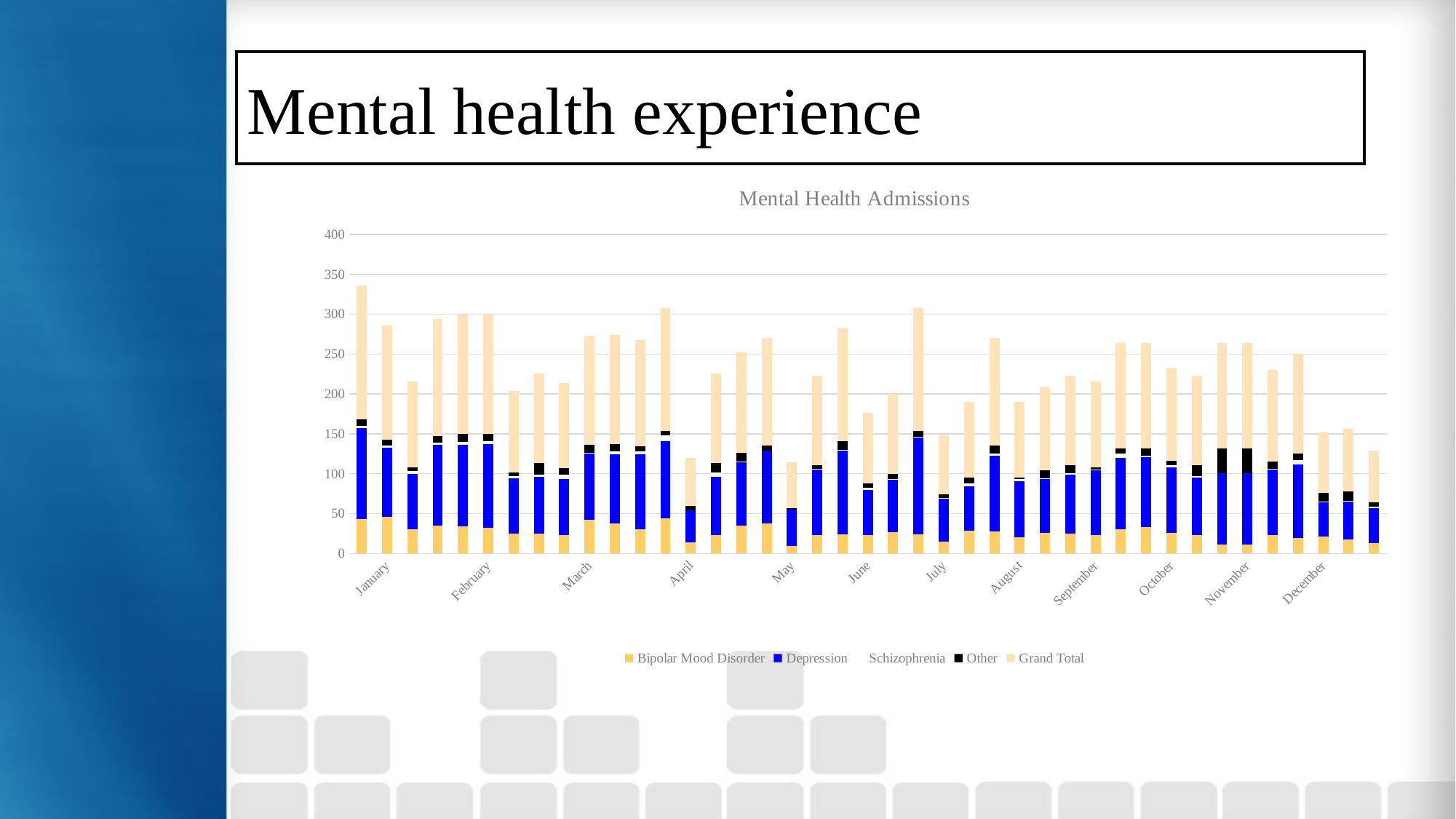
In which month does the tallest bar in the chart appear? January How many month labels are shown on the x axis? 12 Is the first bar in February greater or less than 250? greater How many series does the chart legend list? 5 What type of chart is shown on the slide? Stacked bar chart Which is taller: the first bar in January or the last bar in December? The first bar in January Are all the bars in December greater or less than 200? less What is the title of the chart? Mental Health Admissions Which series is shown in blue in the chart? Depression Do the bar heights generally rise or fall from January to December? Fall Is the tallest bar in January greater or less than 300? greater